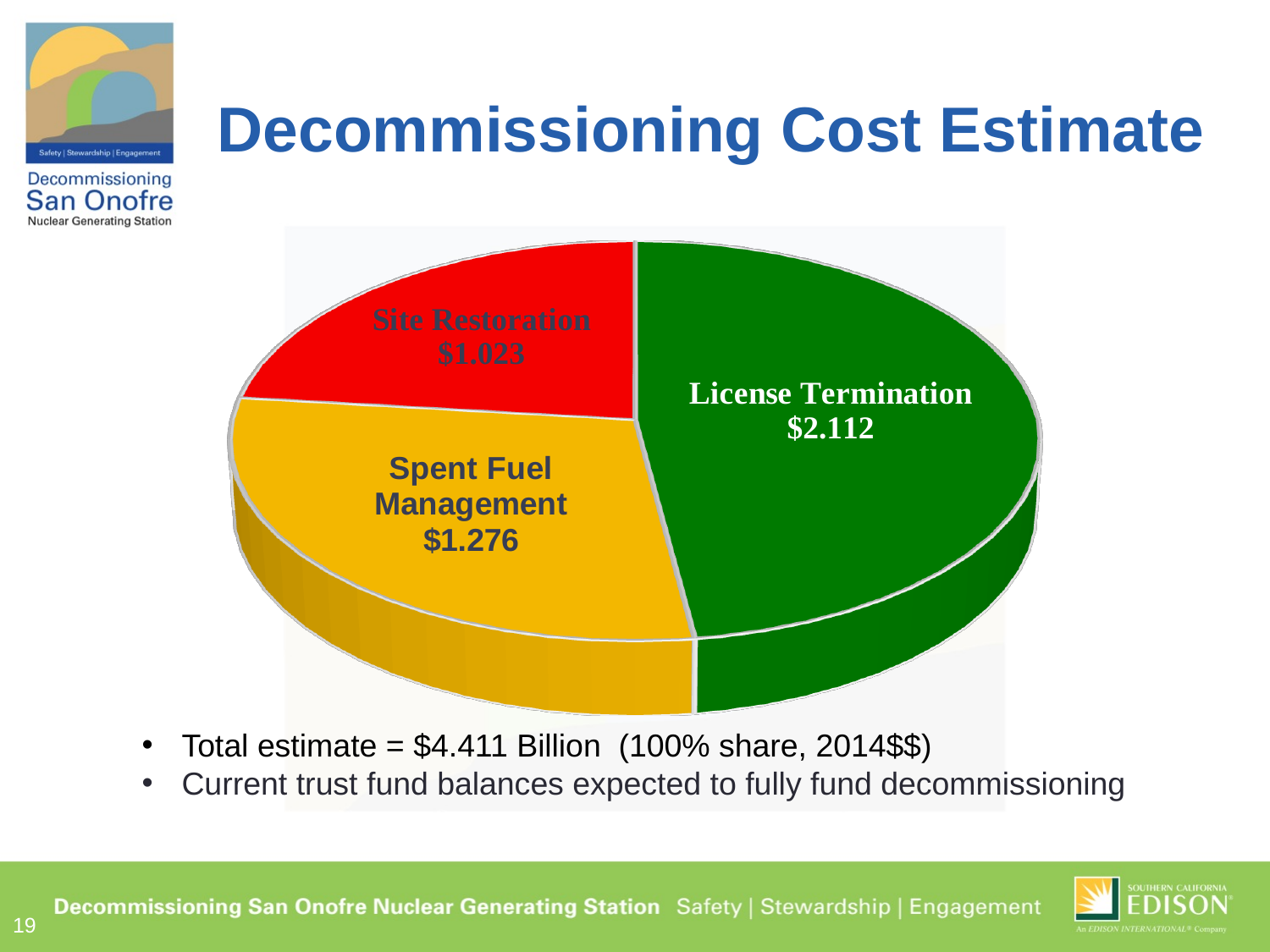
What is the value shown for Spent Fuel Management in the pie chart? $1.276 What is the total estimate stated on the slide for all slices combined? $4.411 Billion What is the value shown for Site Restoration in the pie chart? $1.023 What is the difference between the License Termination value and the Spent Fuel Management value? $0.836 How many slices does the pie chart have? 3 Which is larger, the Spent Fuel Management value or the Site Restoration value? Spent Fuel Management Which category has the smallest slice in the pie chart? Site Restoration What is the difference between the Spent Fuel Management value and the Site Restoration value? $0.253 What kind of chart is shown on the slide? Pie chart What colour is the License Termination slice? Green Which category has the largest slice in the pie chart? License Termination What is the value shown for License Termination in the pie chart? $2.112